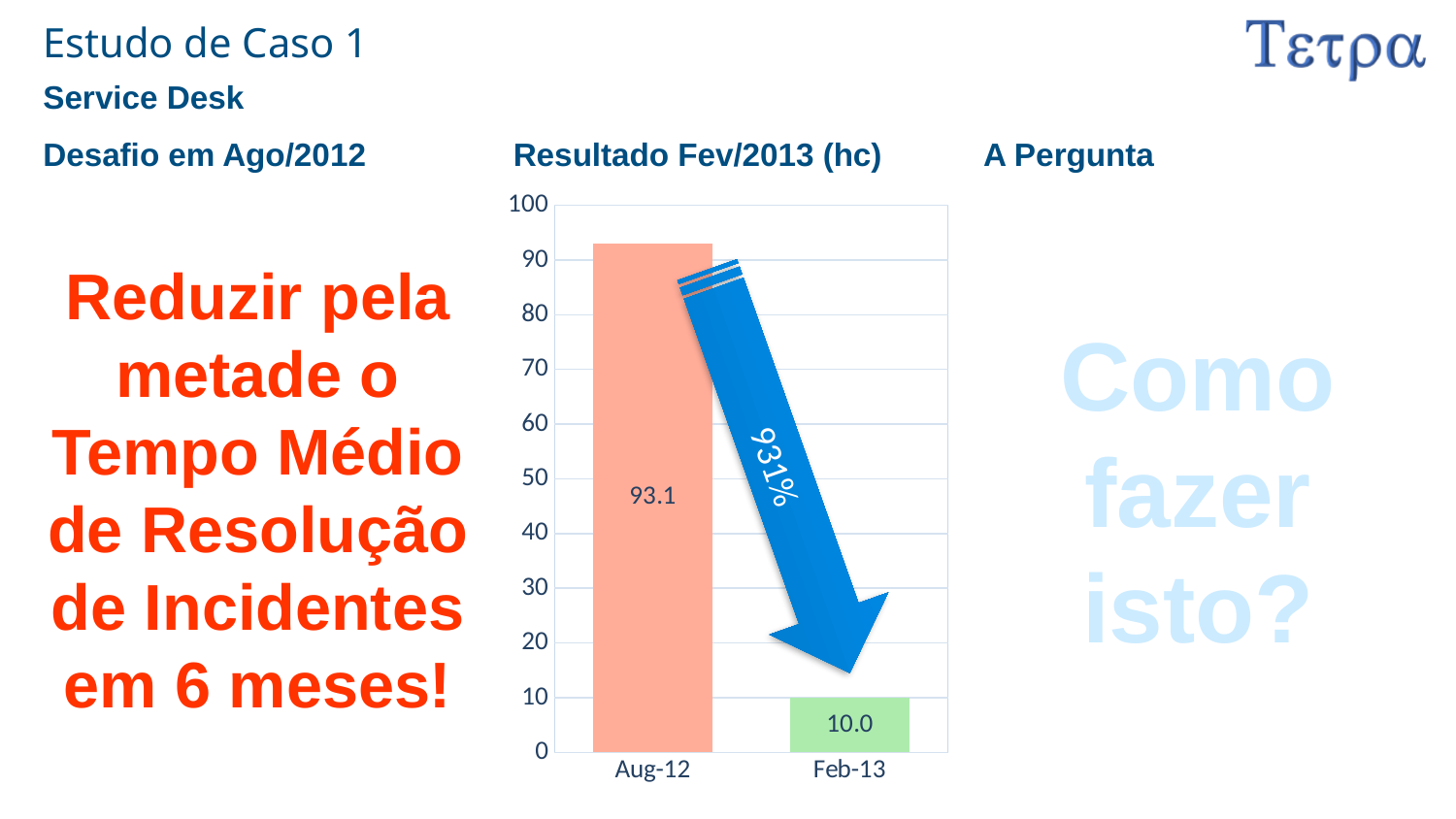
Is the value for Feb-13 greater or less than 20? less Which category has the highest value? Aug-12 What is the difference between the Aug-12 and Feb-13 values? 83.1 Which category has the lowest value? Feb-13 What kind of chart is shown? bar chart How many categories are shown on the x axis? 2 Is the value for Aug-12 greater or less than 90? greater What percentage is written on the blue arrow over the chart? 931% Do the values rise or fall from Aug-12 to Feb-13? fall What is the value for Aug-12? 93.1 What is the value for Feb-13? 10.0 Which is larger, the value for Aug-12 or the value for Feb-13? Aug-12